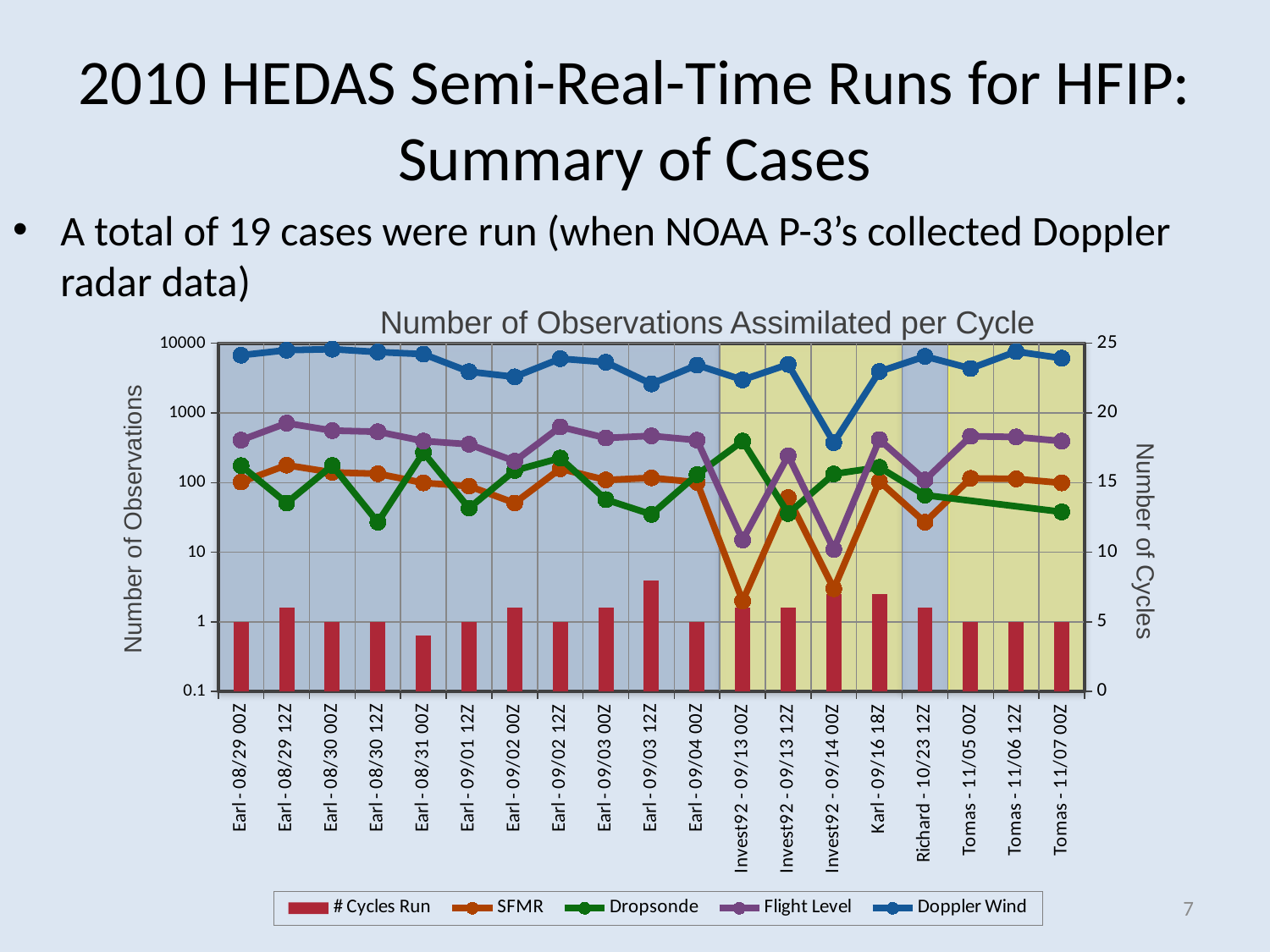
How many series does the chart legend list? 5 What is the title of the chart? Number of Observations Assimilated per Cycle Which case has the lowest SFMR value? Invest92 - 09/13 00Z How many cases (categories) are shown along the x axis of the chart? 19 What is the label of the right-hand vertical axis? Number of Cycles Which case has the lowest Doppler Wind value? Invest92 - 09/14 00Z What kind of chart is this? Combination bar and line chart Is the Doppler Wind value for Invest92 - 09/14 00Z greater or less than 1000? less Which case has the highest number of cycles run (tallest bar)? Earl - 09/03 12Z For Earl - 08/29 12Z, which is larger: the Flight Level value or the Dropsonde value? Flight Level Is the SFMR value for Invest92 - 09/13 00Z greater or less than 10? less